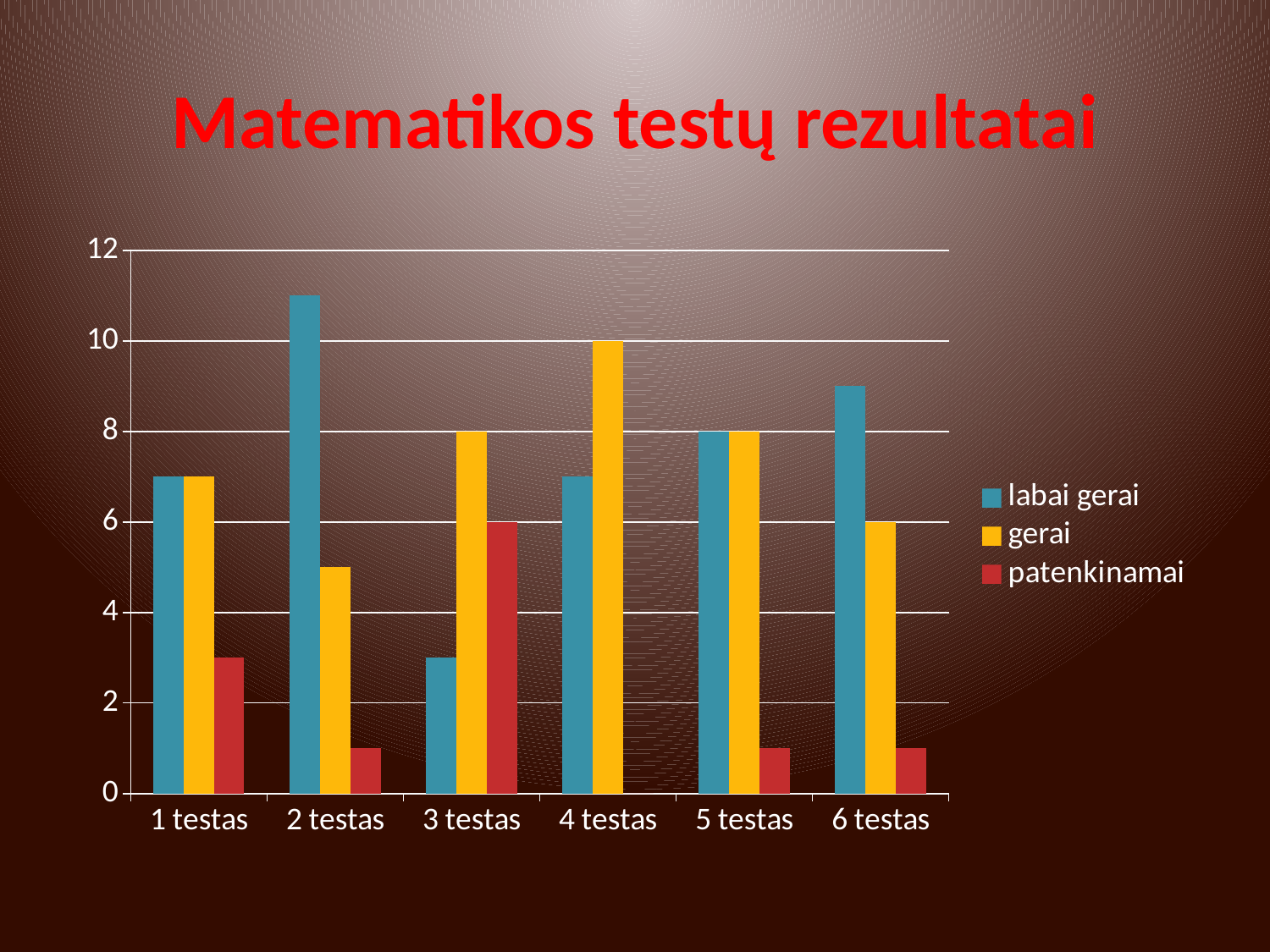
What is the value for 'patenkinamai' in 3 testas? 6 Is the value for 'labai gerai' in 2 testas greater or less than 10? greater Which test has the highest 'labai gerai' value? 2 testas How many test categories are shown on the x axis? 6 What is the difference between the 'gerai' values for 4 testas and 6 testas? 4 What kind of chart is shown on the slide? bar chart Which test has the lowest 'gerai' value? 2 testas What is the value for 'gerai' in 4 testas? 10 What is the title of the chart? Matematikos testų rezultatai In 2 testas, which is larger: 'labai gerai' or 'gerai'? labai gerai What is the value for 'labai gerai' in 5 testas? 8 How many series does the legend list? 3